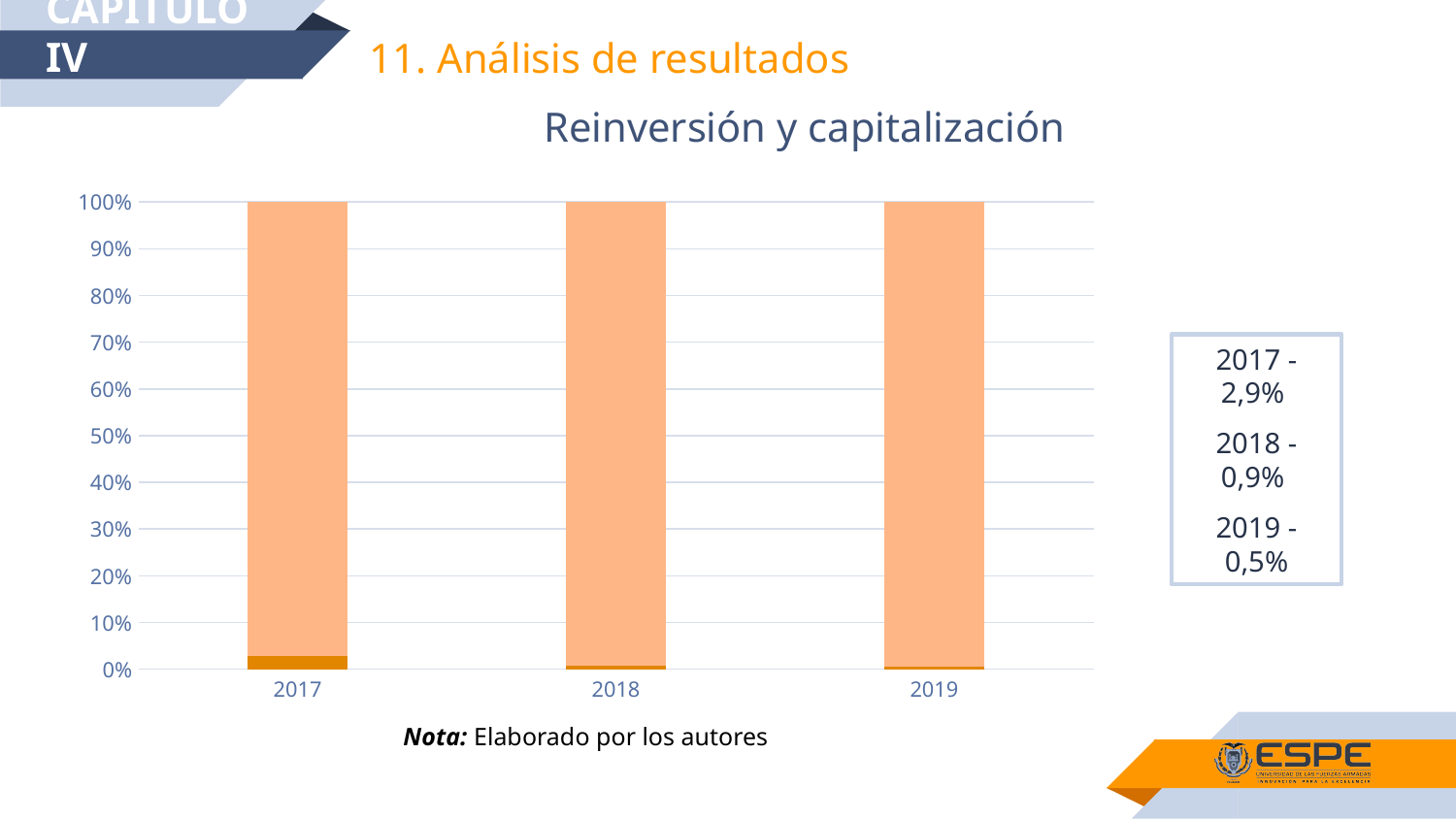
Does the dark orange segment rise or fall from 2017 to 2019? fall According to the text box beside the chart, what is the value for 2018? 0,9% Which year has the largest dark orange segment at the bottom of its bar? 2017 Is the dark orange segment for 2017 larger or smaller than the one for 2019? larger How many years are shown on the x axis of the chart? 3 What is the total height of the stacked bar for 2017? 100% What is the total height of the stacked bar for 2019? 100% According to the text box beside the chart, what is the value for 2019? 0,5% What kind of chart is shown on the slide? bar chart According to the text box beside the chart, what is the value for 2017? 2,9% What is the title of the chart? Reinversión y capitalización Which year has the smallest value according to the text box beside the chart? 2019